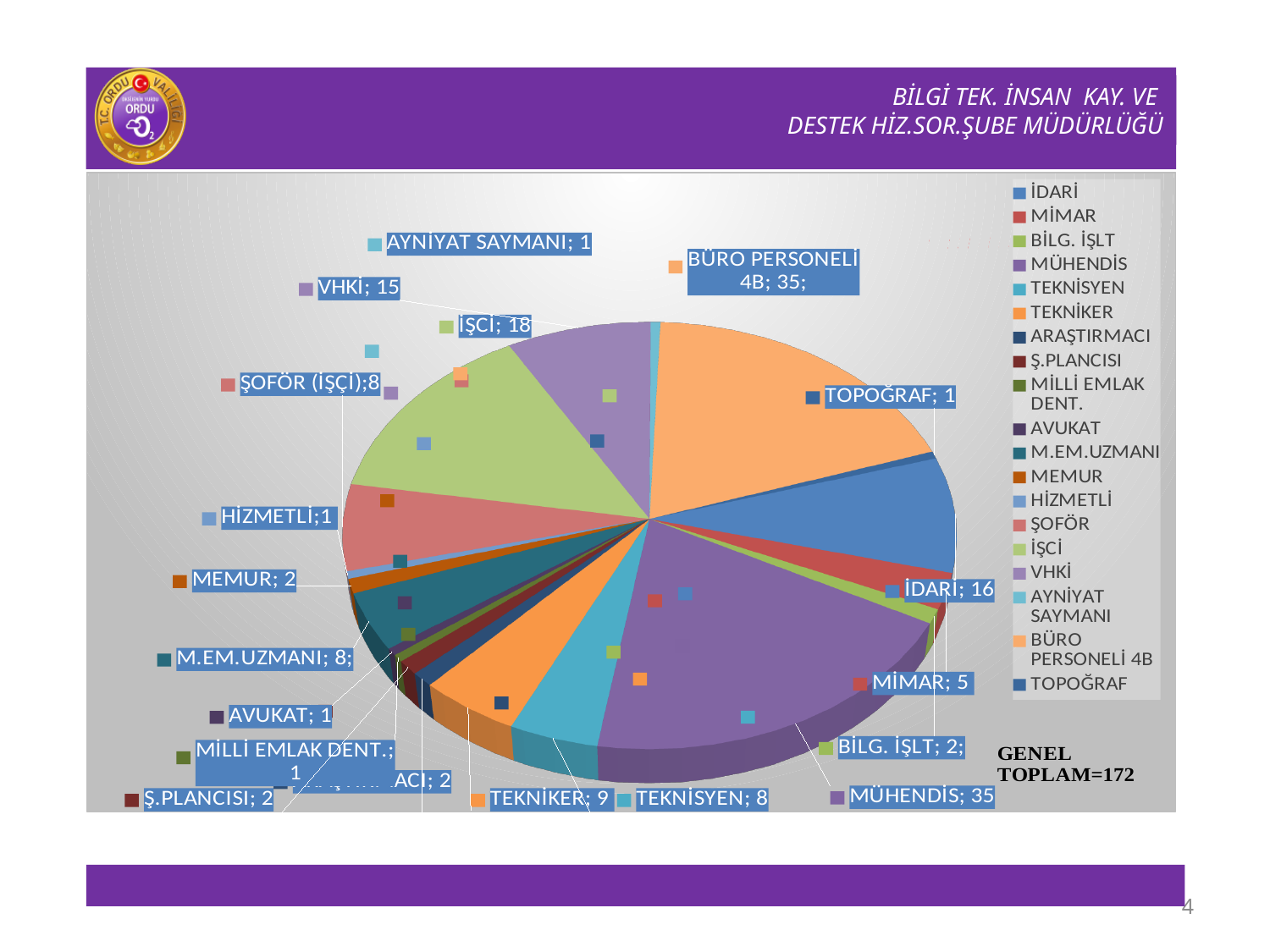
What is the value for MÜHENDİS? 35 What kind of chart is shown on the slide? pie chart Which is larger, İŞÇİ or VHKİ? İŞÇİ What is the value for TEKNİKER? 9 What is the value for M.EM.UZMANI? 8 What is the difference between the values for İŞÇİ and VHKİ? 3 What is the difference between the values for İDARİ and MİMAR? 11 What is the value for VHKİ? 15 How many categories does the legend list? 19 What is the value for BÜRO PERSONELİ 4B? 35 What is the value for İDARİ? 16 What overall total (GENEL TOPLAM) is stated next to the chart? 172